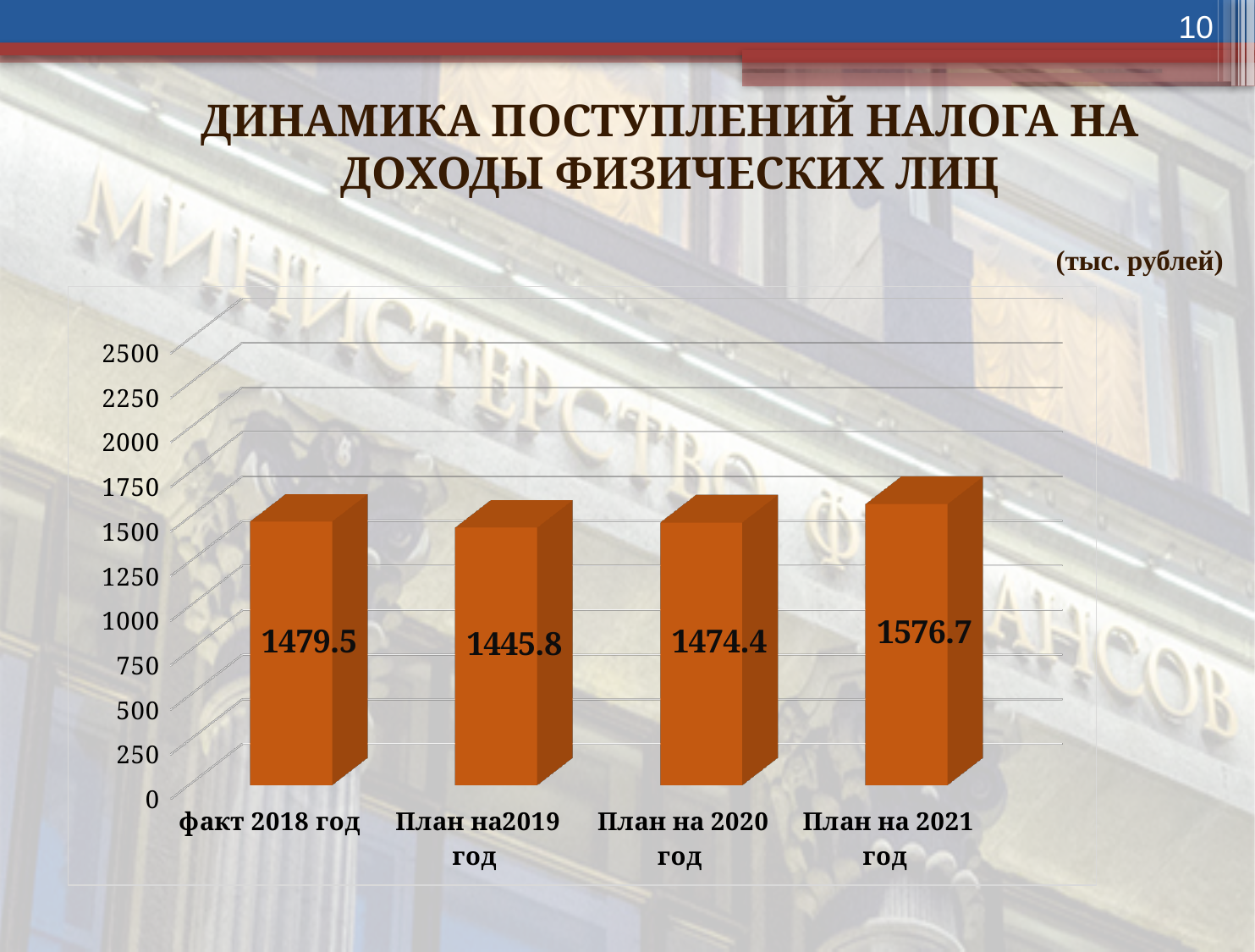
What is the difference between the values for План на 2021 год and факт 2018 год? 97.2 Which category has the lowest value? План на2019 год Which category has the highest value? План на 2021 год What is the value for План на 2020 год? 1474.4 Which is larger, the value for План на 2021 год or the value for План на 2020 год? План на 2021 год What is the value for План на2019 год? 1445.8 Is the value for План на2019 год greater or less than 1500? less What is the value for факт 2018 год? 1479.5 What is the difference between the values for План на 2021 год and План на2019 год? 130.9 What unit of measurement is indicated for the chart? тыс. рублей How many categories are shown on the chart? 4 What is the value for План на 2021 год? 1576.7